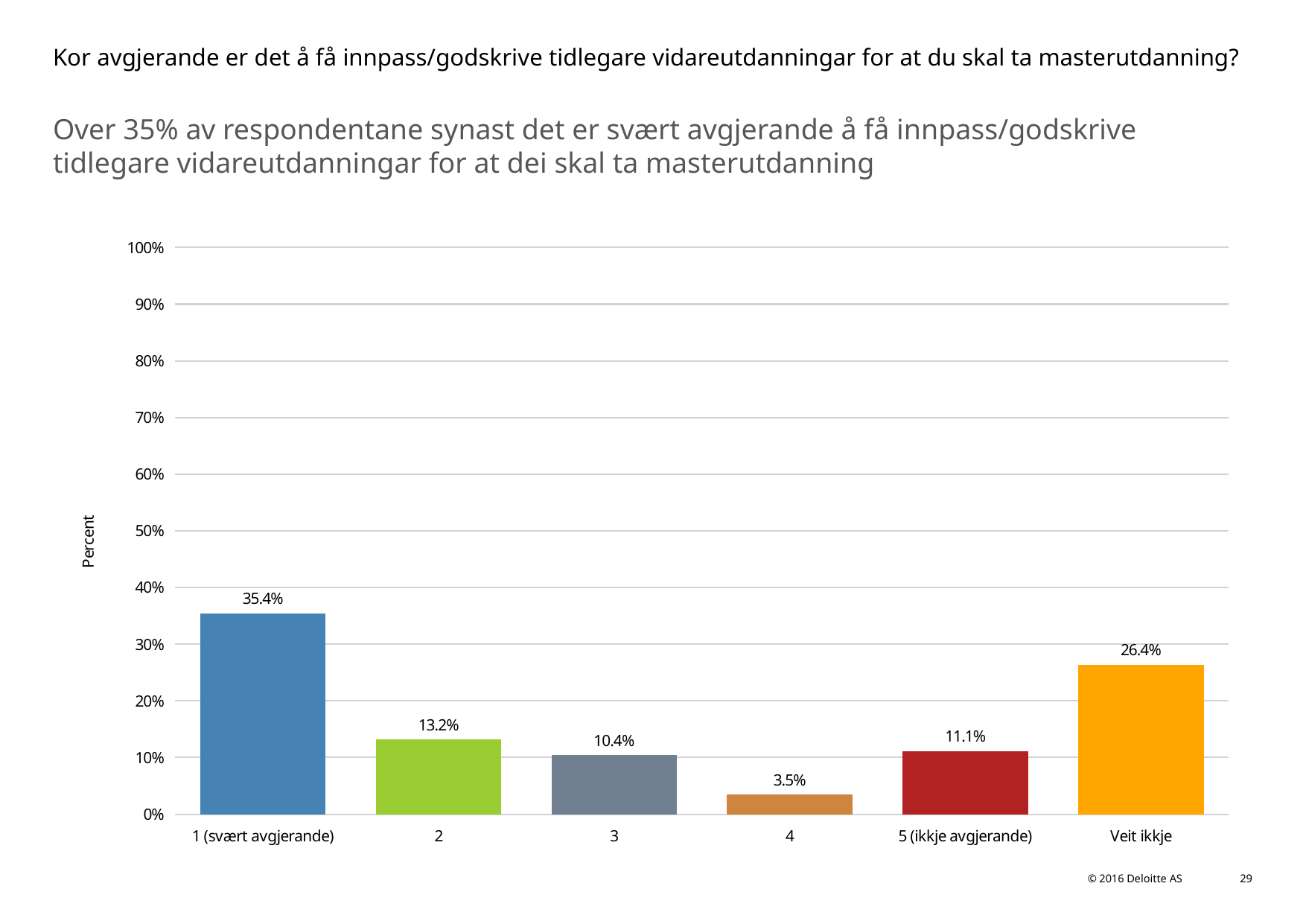
Which is larger, the value for category 2 or the value for category 3? 2 What is the value for "5 (ikkje avgjerande)"? 11.1% How many categories are shown on the x axis? 6 What is the label of the y axis? Percent What is the difference between the values for "1 (svært avgjerande)" and "Veit ikkje"? 9.0% What kind of chart is shown on the slide? bar chart What is the value for "1 (svært avgjerande)"? 35.4% Which category has the highest value? 1 (svært avgjerande) What is the value for "Veit ikkje"? 26.4% What is the value for category 4? 3.5% Is the value for "Veit ikkje" greater or less than 20%? greater Which category has the lowest value? 4